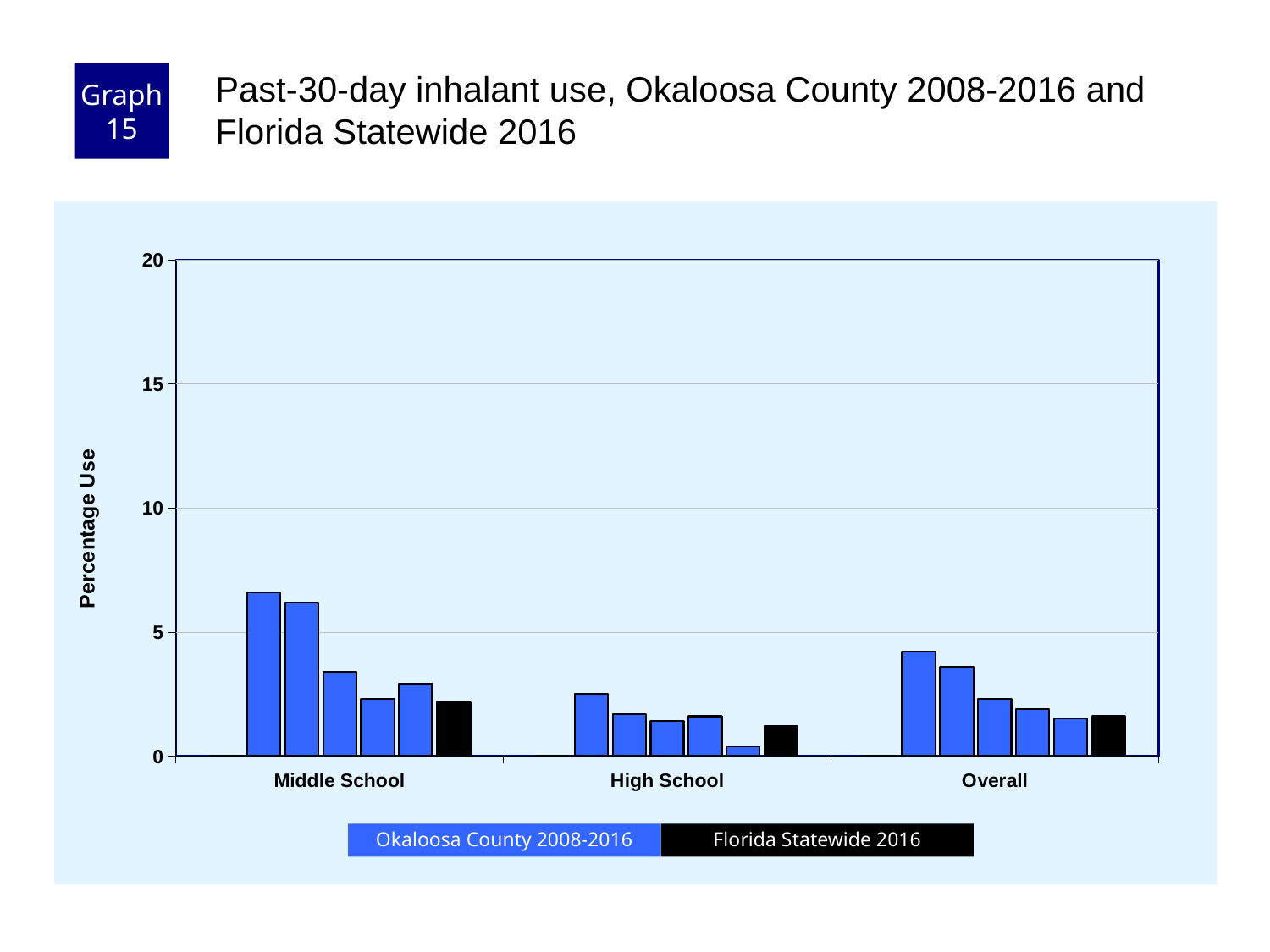
Which category group contains the shortest bar on the chart? High School Which category group has the tallest bar overall? Middle School What kind of chart is shown on the slide? bar chart Which series is shown in black in the legend? Florida Statewide 2016 How many school-level categories are shown on the x axis? 3 What is the label on the vertical axis? Percentage Use Is the value for the Florida Statewide 2016 bar in the High School group greater or less than 5? less How many series does the legend list? 2 Is the Florida Statewide 2016 bar larger for Middle School or for High School? Middle School Is the value for the tallest Overall bar greater or less than 5? less Is the value for the tallest Middle School bar greater or less than 5? greater